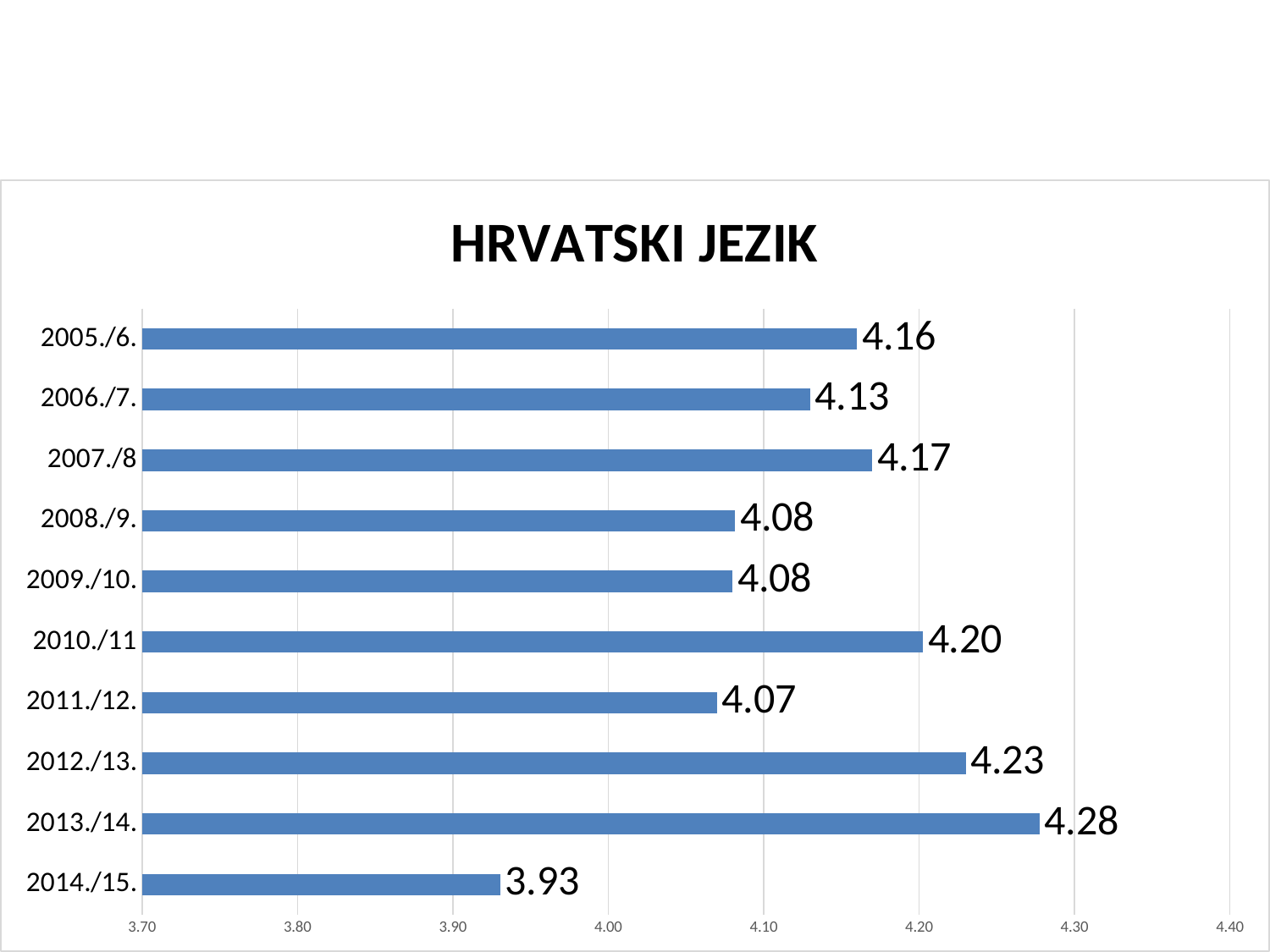
What is the value for 2014./15.? 3.93 What is the value for 2013./14.? 4.28 Which category has the lowest value? 2014./15. What kind of chart is this? bar chart Which category has the highest value? 2013./14. What is the title of the chart? HRVATSKI JEZIK Which is larger, the value for 2007./8 or the value for 2008./9.? 2007./8 What is the difference between the values for 2012./13. and 2011./12.? 0.16 How many categories are shown on the chart? 10 What is the value for 2010./11? 4.20 Is the value for 2014./15. greater or less than 4.00? less What is the difference between the values for 2013./14. and 2014./15.? 0.35